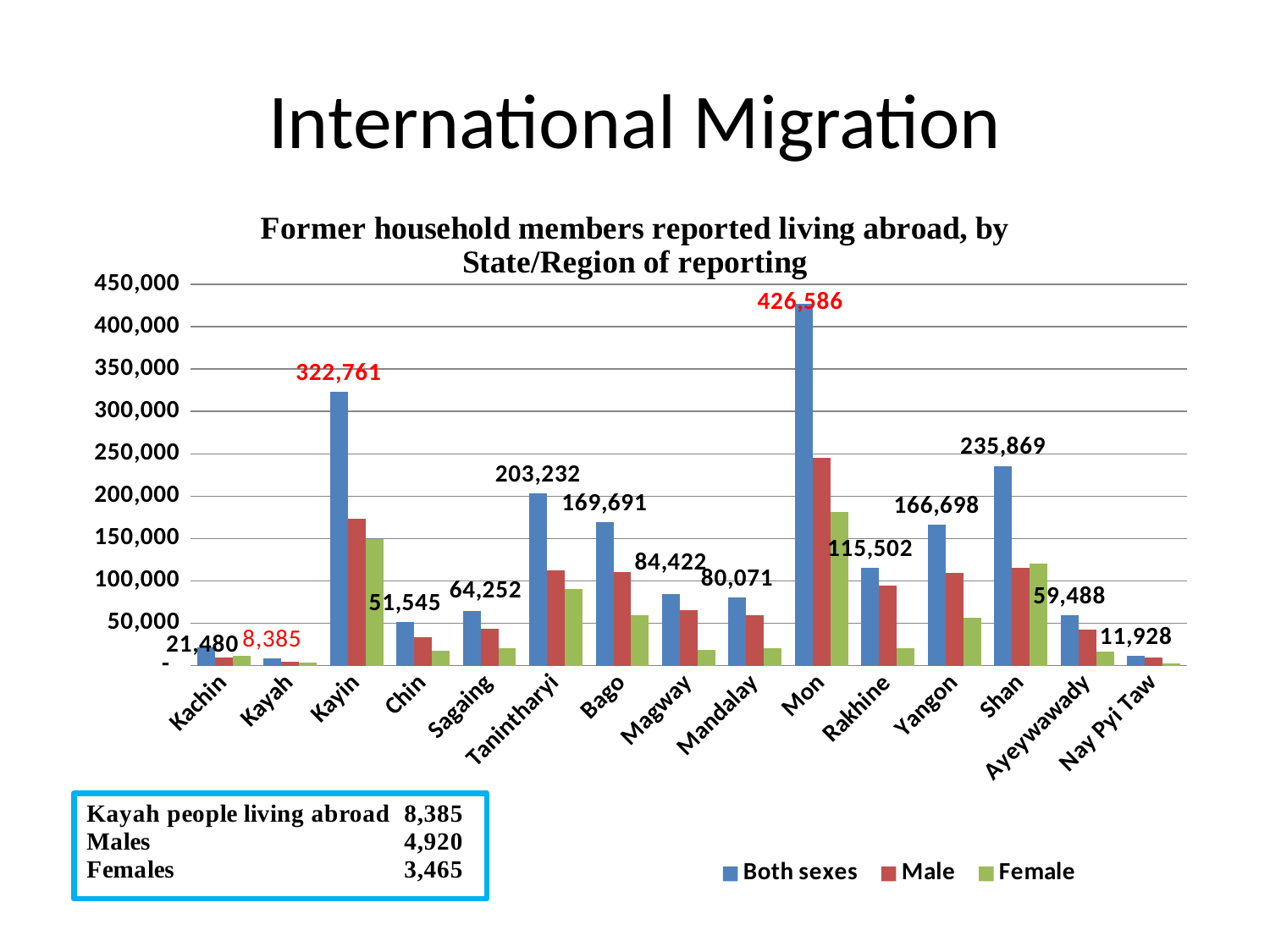
Which has a larger Both sexes value, Shan or Yangon? Shan What is the value for Both sexes in Kayin? 322,761 What is the value for Both sexes in Nay Pyi Taw? 11,928 What kind of chart is shown on the slide? Bar chart What is the difference between the Both sexes values for Mon and Kayin? 103,825 What is the value for Both sexes in Tanintharyi? 203,232 Which State/Region has the lowest value for Both sexes? Kayah Is the Male value for Mon greater or less than 200,000? greater How many series does the legend list? 3 Which State/Region has the highest value for Both sexes? Mon Is the Female value for Kayin greater or less than 100,000? greater How many States/Regions are shown on the x axis? 15